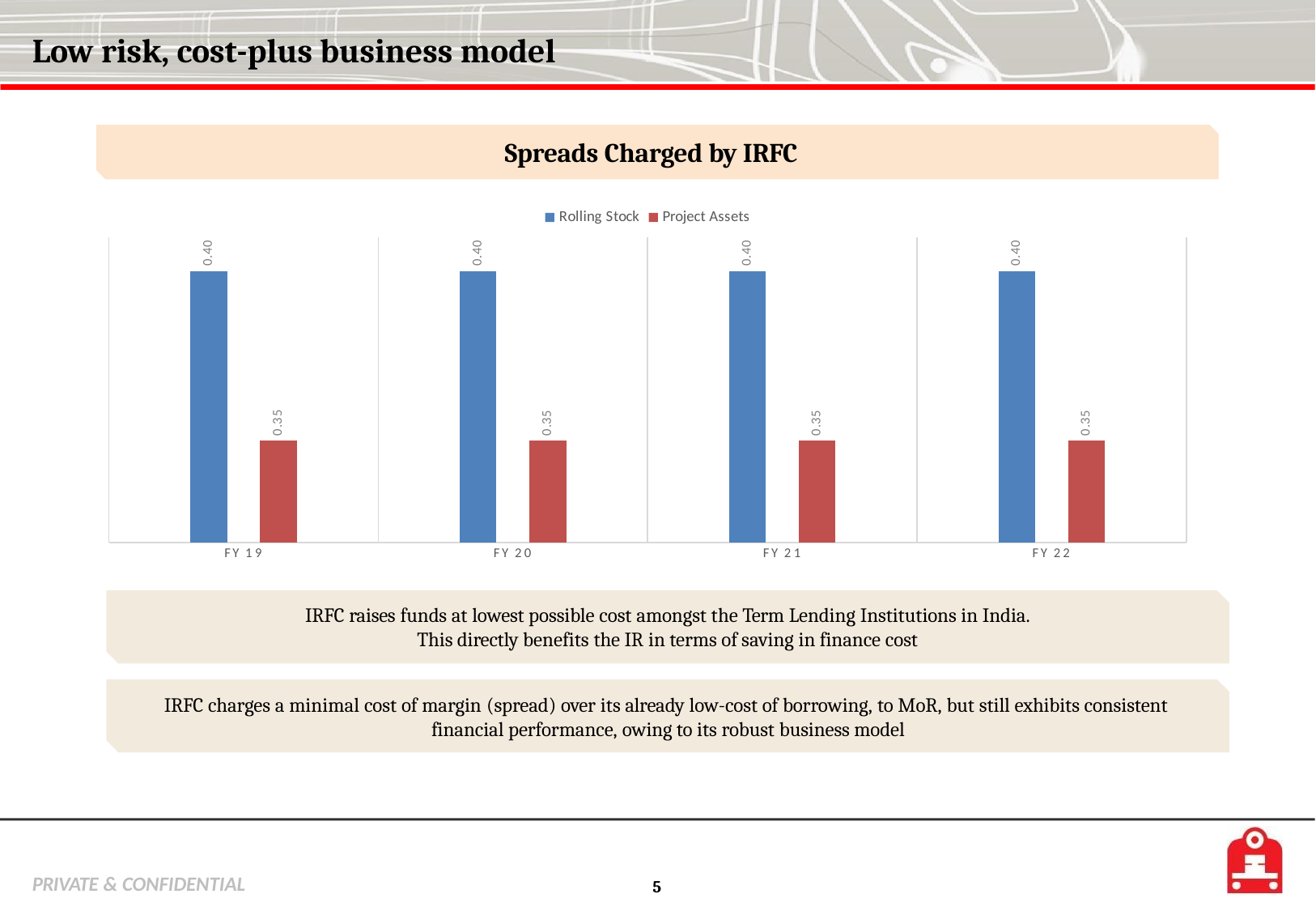
How many fiscal years are shown on the x axis of the chart? 4 What is the Rolling Stock spread charged by IRFC in FY 19? 0.40 Does the Rolling Stock spread rise, fall or stay flat from FY 19 to FY 22? Stays flat What is the title of the chart? Spreads Charged by IRFC Which series has the larger value in FY 20, Rolling Stock or Project Assets? Rolling Stock What is the Project Assets value for FY 20? 0.35 What is the difference between the Rolling Stock and Project Assets spreads in FY 21? 0.05 What is the Rolling Stock value for FY 21? 0.40 What is the Project Assets spread charged by IRFC in FY 22? 0.35 What kind of chart is used to show the spreads charged by IRFC? Bar chart Which colour represents Project Assets in the chart? Red How many series does the chart legend list? 2